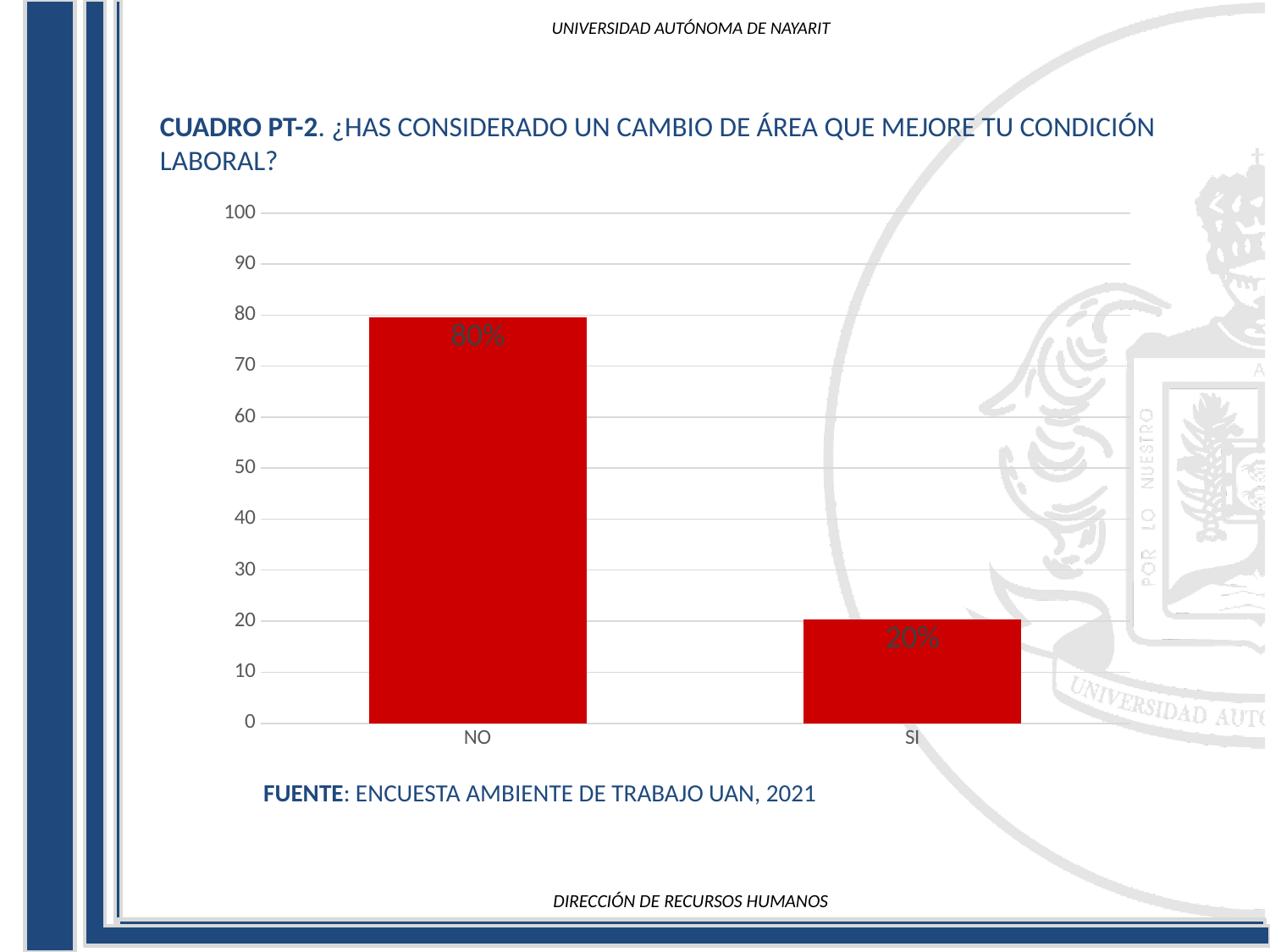
Which category has the highest value? NO Which category has the lowest value? SI What is the value for NO? 80% What is the difference between the values for NO and SI? 60% Is the value for SI greater or less than 30? less What kind of chart is shown on the slide? bar chart How many categories are shown on the x axis? 2 What colour are the bars in the chart? red What is the value for SI? 20% What is the maximum value shown on the y axis? 100 Is the value for NO greater or less than 50? greater Which is larger, the value for NO or the value for SI? NO